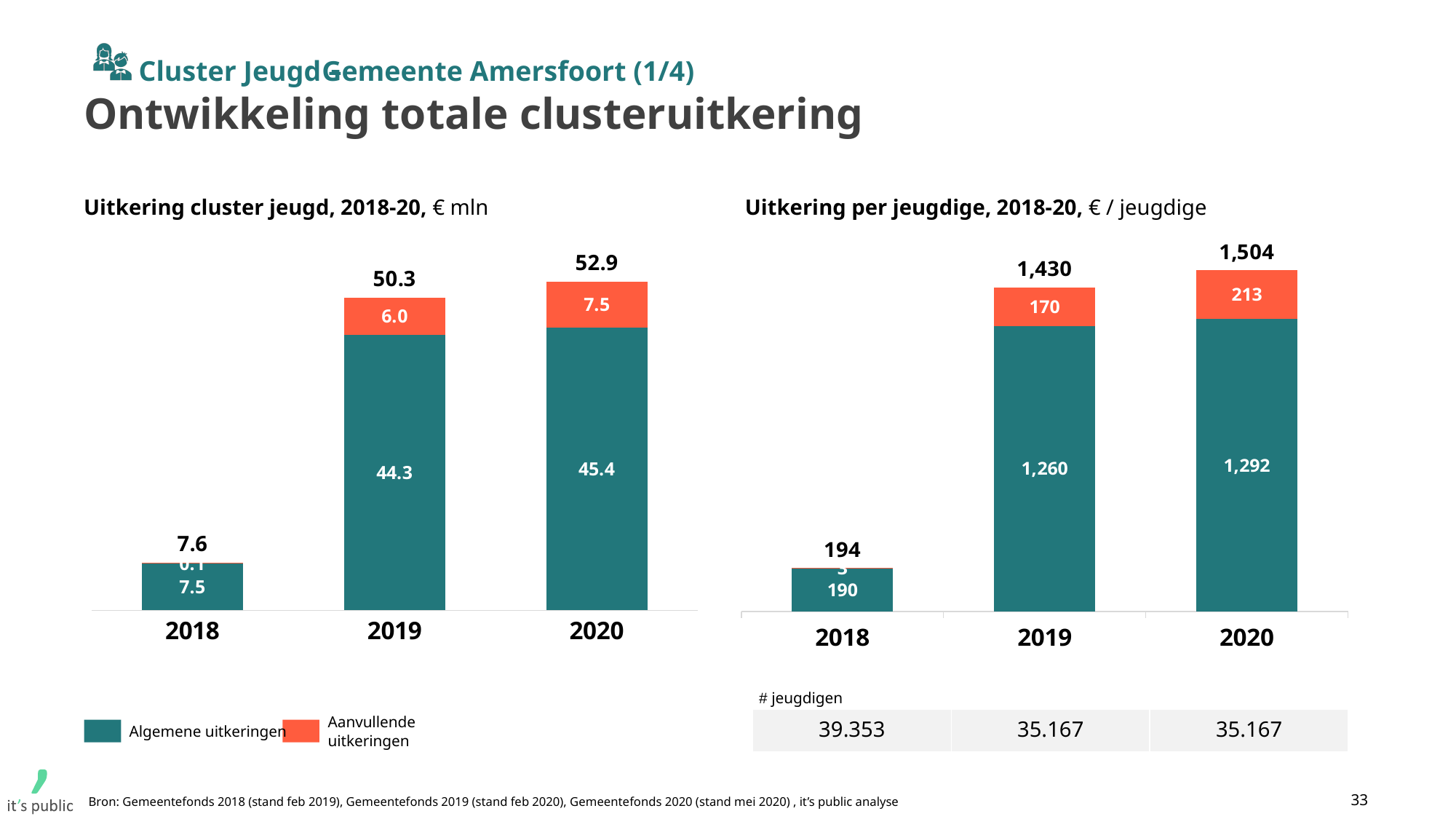
How many series does the legend list for the charts on the slide? 2 In the chart 'Uitkering per jeugdige, 2018-20', what is the total of the stacked bar for 2019? 1,430 In the chart 'Uitkering cluster jeugd, 2018-20', what is the value of Algemene uitkeringen for 2019? 44.3 In the chart 'Uitkering per jeugdige, 2018-20', which year has the highest total? 2020 In the chart 'Uitkering cluster jeugd, 2018-20', what is the difference between the totals for 2020 and 2019? 2.6 In the chart 'Uitkering cluster jeugd, 2018-20', what is the value of Aanvullende uitkeringen for 2020? 7.5 In the chart 'Uitkering per jeugdige, 2018-20', is the Aanvullende uitkeringen value larger for 2019 or 2020? 2020 In the chart 'Uitkering per jeugdige, 2018-20', what is the value of Algemene uitkeringen for 2020? 1,292 In the chart 'Uitkering per jeugdige, 2018-20', what is the value of Aanvullende uitkeringen for 2019? 170 What kind of chart is 'Uitkering cluster jeugd, 2018-20'? Stacked bar chart In the chart 'Uitkering cluster jeugd, 2018-20', what is the total of the stacked bar for 2020? 52.9 In the chart 'Uitkering cluster jeugd, 2018-20', which year has the lowest total? 2018